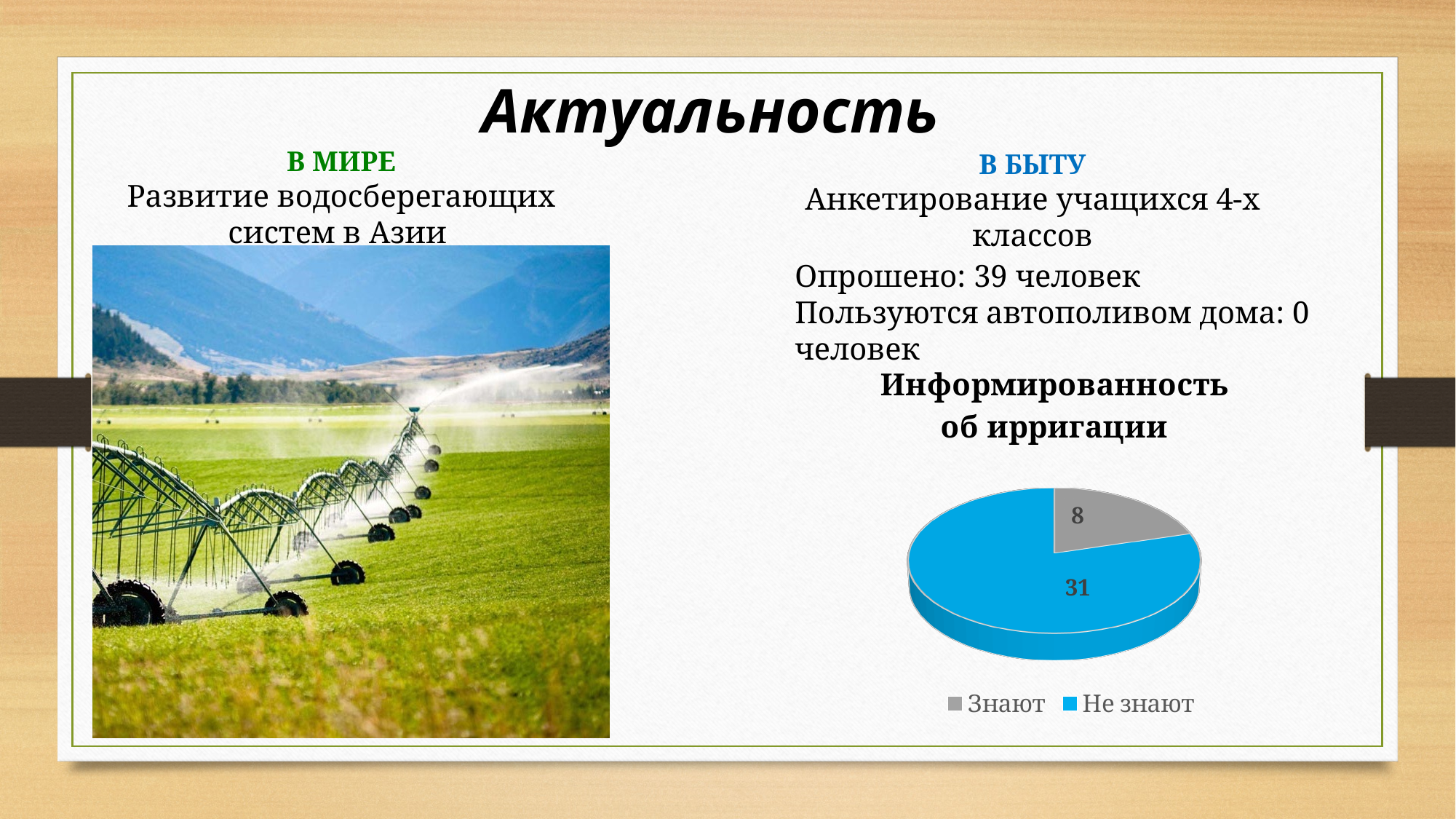
Which slice of the pie chart is the largest? Не знают What is the title of the pie chart? Информированность об ирригации How many slices does the pie chart have? 2 What is the value for "Знают" in the pie chart? 8 What is the total of the two values shown in the pie chart? 39 Which is larger in the pie chart, "Знают" or "Не знают"? Не знают What is the difference between the "Не знают" and "Знают" values in the pie chart? 23 What is the value for "Не знают" in the pie chart? 31 What kind of chart is shown on the slide? Pie chart Which slice of the pie chart is the smallest? Знают What colour is the "Не знают" slice in the pie chart? Blue How many entries does the legend of the pie chart list? 2